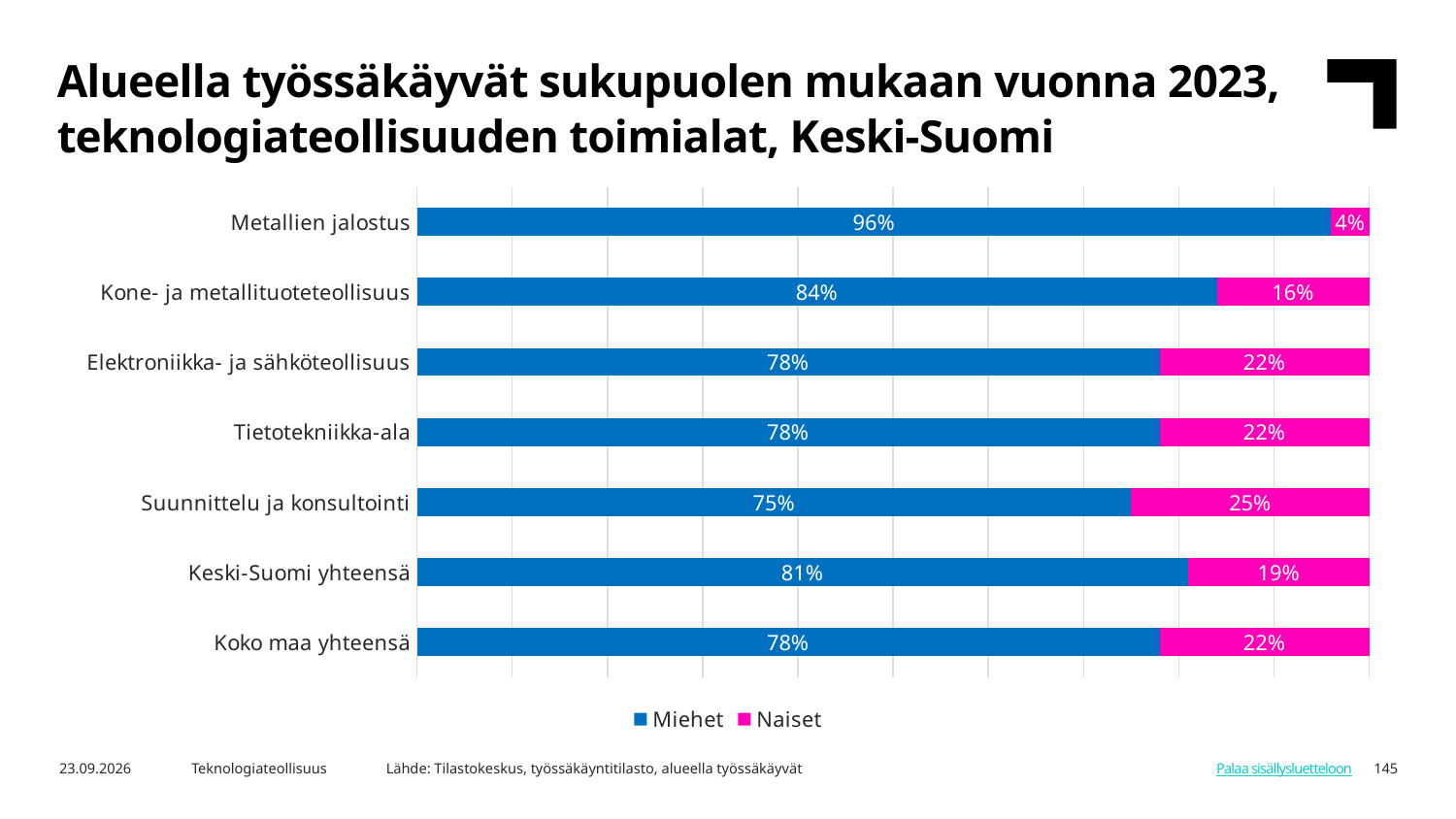
How many series does the legend list? 2 Which category has the highest Naiset share? Suunnittelu ja konsultointi Which category has the lowest Naiset share? Metallien jalostus How many categories are shown on the chart? 7 What kind of chart is shown on the slide? Stacked bar chart Which is larger, the Naiset share for Keski-Suomi yhteensä or for Koko maa yhteensä? Koko maa yhteensä What is the difference between the Miehet share for Metallien jalostus and for Suunnittelu ja konsultointi? 21 percentage points What is the Naiset share for Kone- ja metallituoteteollisuus? 16% What is the Miehet share for Metallien jalostus? 96% Which category has the highest Miehet share? Metallien jalostus What is the Naiset share for Suunnittelu ja konsultointi? 25% What is the Miehet share for Keski-Suomi yhteensä? 81%